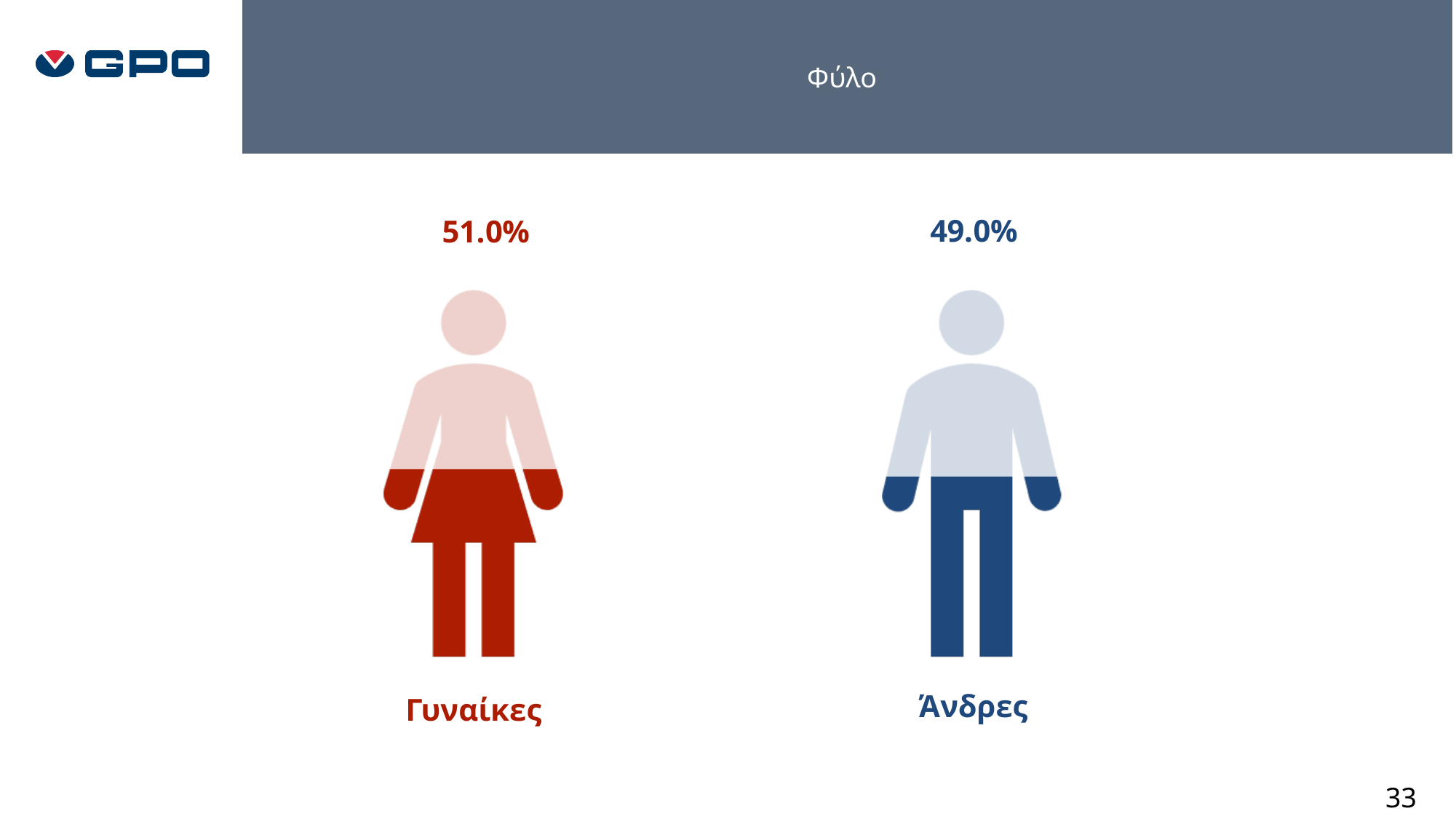
What is the value shown for Γυναίκες? 51.0% What kind of chart is shown on the slide? pictogram (infographic with filled figures) What is the title of the chart? Φύλο Is the value for Άνδρες larger or smaller than the value for Γυναίκες? smaller What is the total of the two percentages shown? 100.0% Which category has the higher value, Γυναίκες or Άνδρες? Γυναίκες What is the difference between the values for Γυναίκες and Άνδρες? 2.0% How many categories are shown on the slide? 2 What colour is used for the Γυναίκες figure? red Which category has the lower value? Άνδρες What is the value shown for Άνδρες? 49.0%